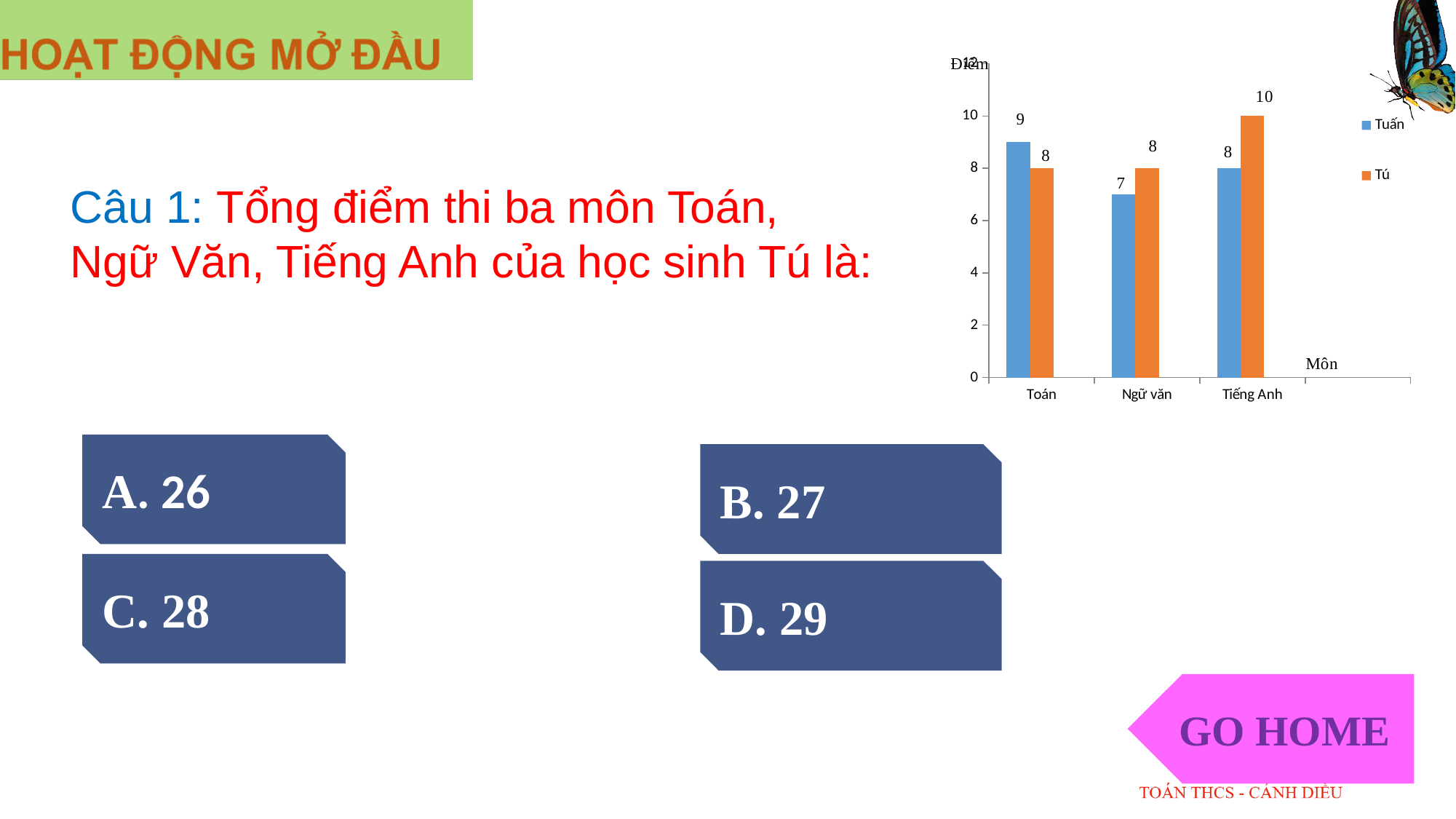
What kind of chart is shown on the slide? bar chart How many series does the legend list? 2 What is the difference between Tú's and Tuấn's scores in Tiếng Anh? 2 In which subject does Tú have the highest score? Tiếng Anh What is Tuấn's score in Ngữ văn? 7 Which colour represents Tú in the chart? orange What is Tú's score in Tiếng Anh? 10 Who has the higher score in Toán, Tuấn or Tú? Tuấn What is Tuấn's score in Toán? 9 In which subject does Tuấn have the lowest score? Ngữ văn How many subjects are shown on the x axis? 3 What is Tú's score in Toán? 8